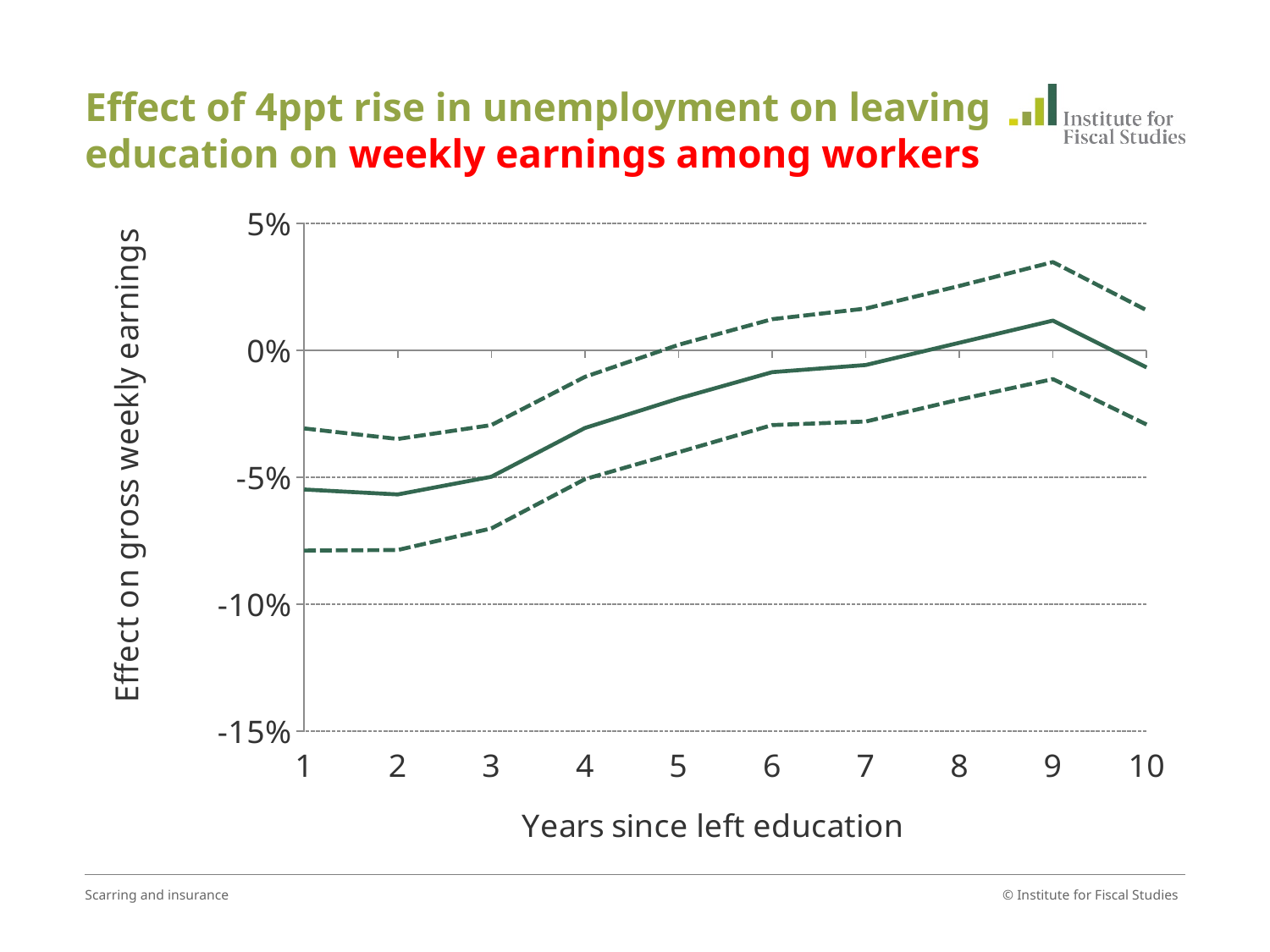
Is the value of the solid line at year 9 greater or less than 0%? greater Is the value of the lower dashed line at year 1 greater or less than -5%? less How many lines are plotted on the chart? 3 Is the value of the upper dashed line at year 9 greater or less than 0%? greater Does the solid line generally rise or fall between year 1 and year 9? rise What is the title of the y axis? Effect on gross weekly earnings How many years since leaving education are plotted along the x axis? 10 At which year since leaving education does the solid line reach its highest value? 9 On the solid line, which is larger: the value at year 4 or the value at year 2? year 4 What kind of chart is shown on the slide? line chart